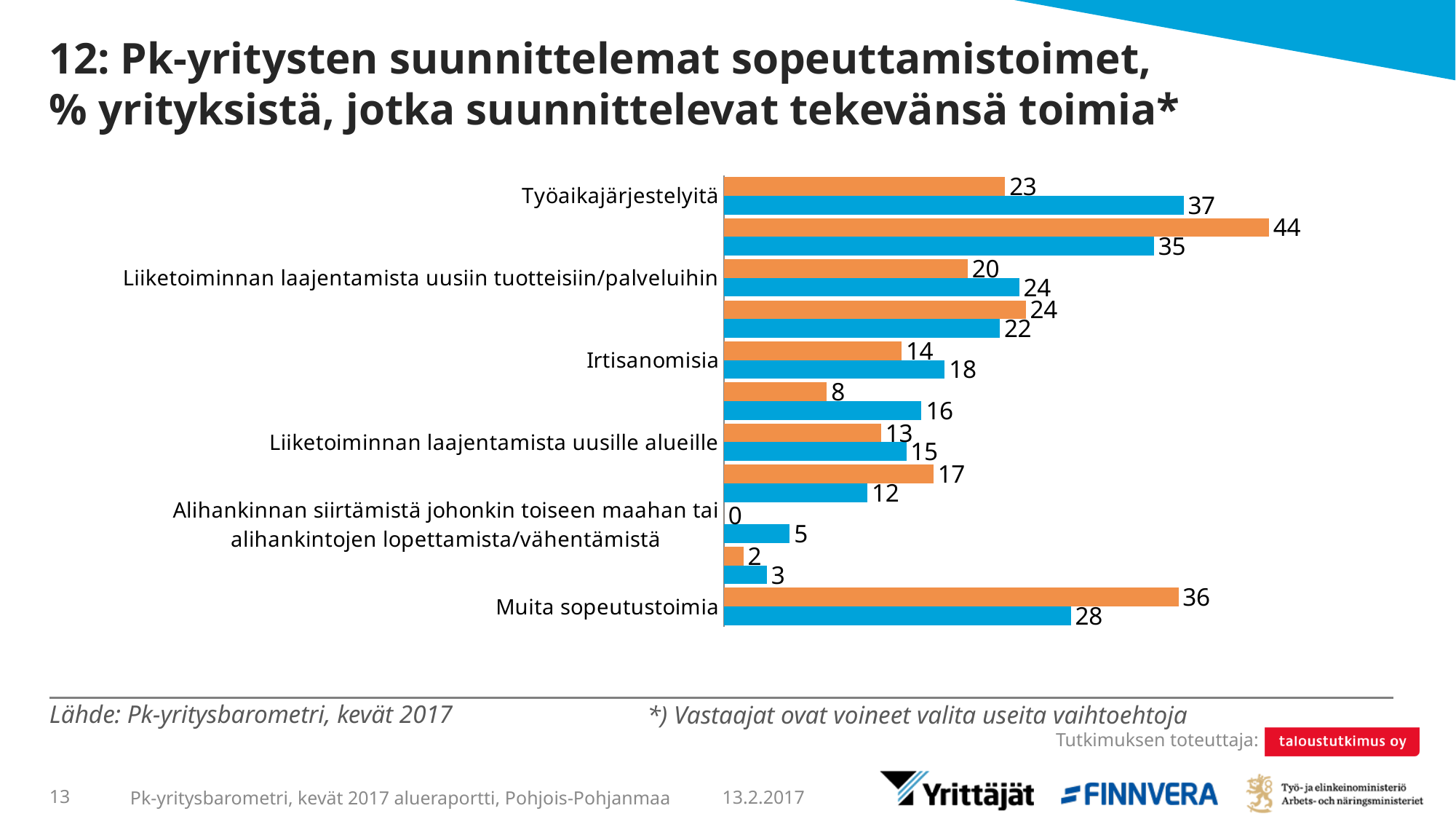
What is the value of the blue bar for Muita sopeutustoimia? 28 What is the difference between the blue and orange bars for Irtisanomisia? 4 What is the value of the orange bar for Työaikajärjestelyitä? 23 What is the highest value shown by any orange bar in the chart? 44 Which labeled category has an orange bar value of 0? Alihankinnan siirtämistä johonkin toiseen maahan tai alihankintojen lopettamista/vähentämistä What kind of chart is shown on the slide? bar chart How much larger is the blue bar than the orange bar for Työaikajärjestelyitä? 14 For Muita sopeutustoimia, which bar is larger, the orange or the blue one? orange What two colours are used for the bars in the chart? orange and blue What is the value of the blue bar for Työaikajärjestelyitä? 37 What is the value of the orange bar for Irtisanomisia? 14 What is the value of the blue bar for Liiketoiminnan laajentamista uusille alueille? 15